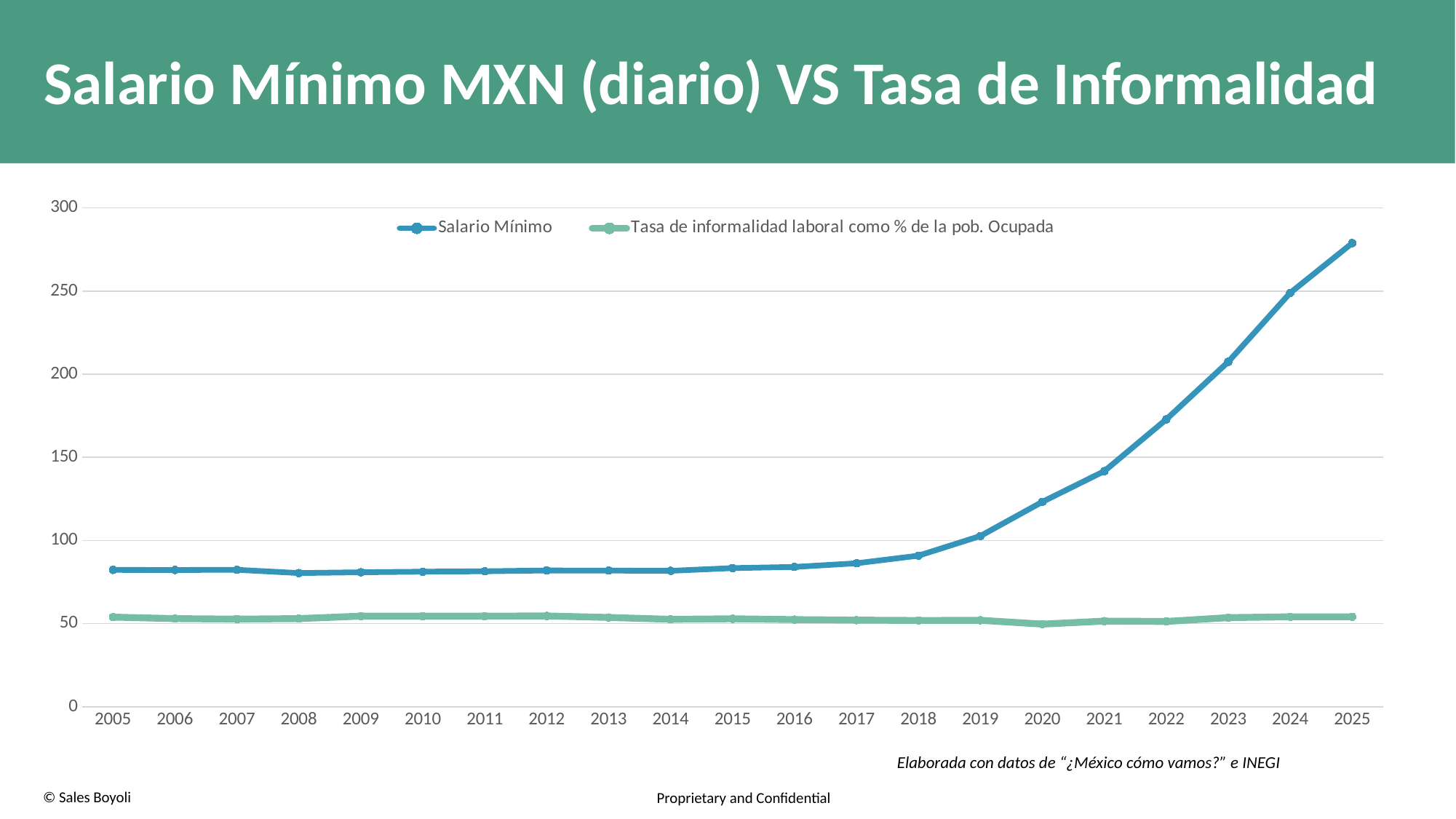
In which year does the Tasa de informalidad laboral series reach its lowest point? 2020 Is the value for Salario Mínimo in 2021 greater or less than 150? less Which series is plotted in blue? Salario Mínimo Is the value for Tasa de informalidad laboral in 2012 greater or less than 100? less Is the value for Salario Mínimo in 2025 greater or less than 250? greater In which year is the Salario Mínimo series at its lowest? 2008 Does the Salario Mínimo series generally rise or fall from 2018 to 2025? rise What kind of chart is shown on the slide? line chart How many years are plotted along the x axis? 21 In which year is the Salario Mínimo series at its highest? 2025 How many series does the legend list? 2